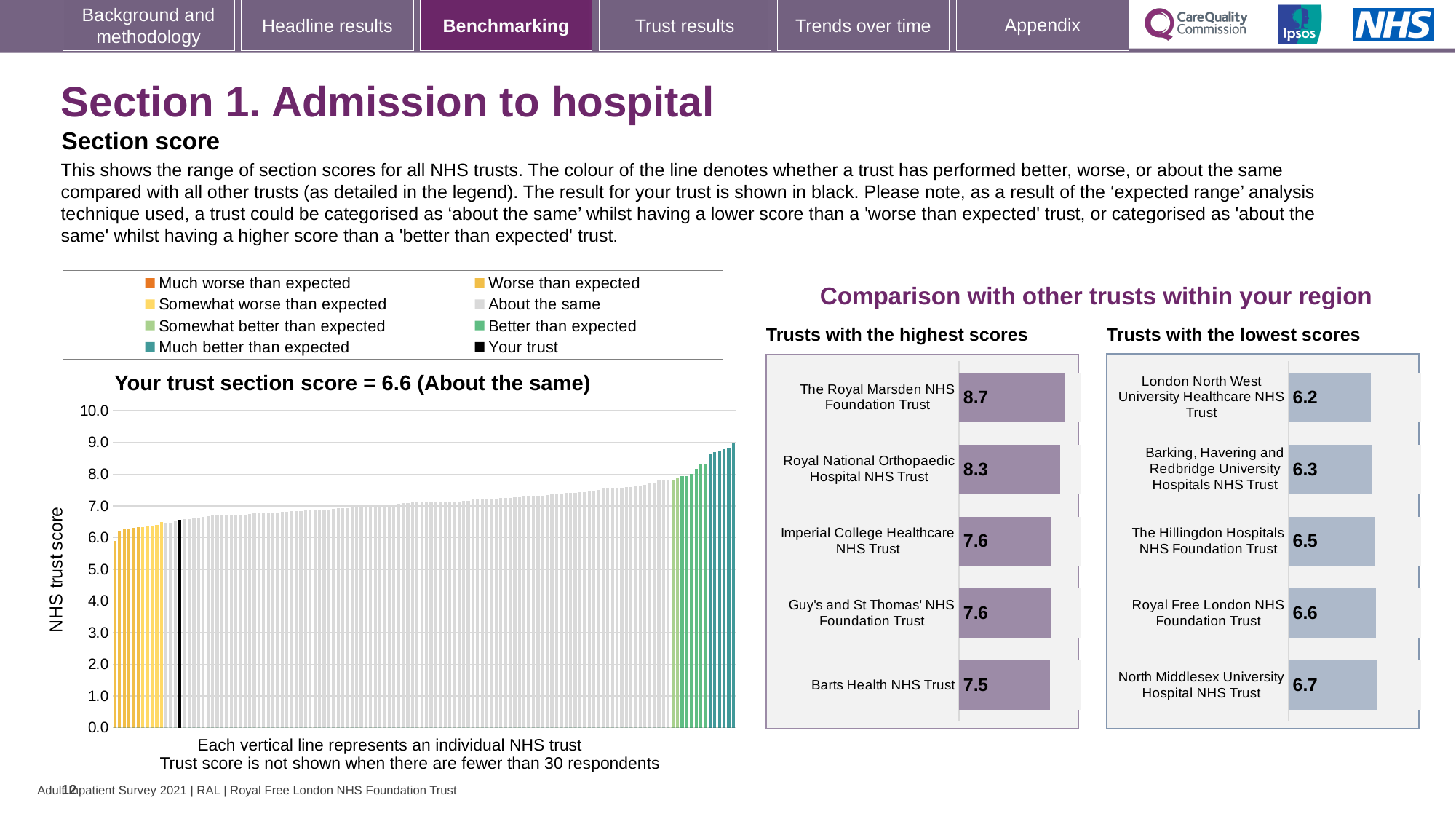
In the 'Trusts with the highest scores' chart, what is the difference between the scores of The Royal Marsden NHS Foundation Trust and Barts Health NHS Trust? 1.2 In the 'Trusts with the lowest scores' chart, what is the score for The Hillingdon Hospitals NHS Foundation Trust? 6.5 What kind of chart is the 'Your trust section score' chart on the left? bar chart In the 'Trusts with the lowest scores' chart, which has the larger score: Royal Free London NHS Foundation Trust or Barking, Havering and Redbridge University Hospitals NHS Trust? Royal Free London NHS Foundation Trust How many entries does the legend above the left-hand chart list? 8 In the 'Trusts with the highest scores' chart, what is the score for The Royal Marsden NHS Foundation Trust? 8.7 In the 'Trusts with the lowest scores' chart, what is the difference between the scores of North Middlesex University Hospital NHS Trust and London North West University Healthcare NHS Trust? 0.5 In the left-hand chart of all NHS trusts, do the trust scores rise or fall from left to right along the x axis? rise In the 'Trusts with the lowest scores' chart, which trust has the lowest score? London North West University Healthcare NHS Trust How many trusts are shown in the 'Trusts with the highest scores' chart? 5 In the 'Trusts with the highest scores' chart, which trust has the highest score? The Royal Marsden NHS Foundation Trust According to the title of the left-hand chart, what is your trust's section score? 6.6